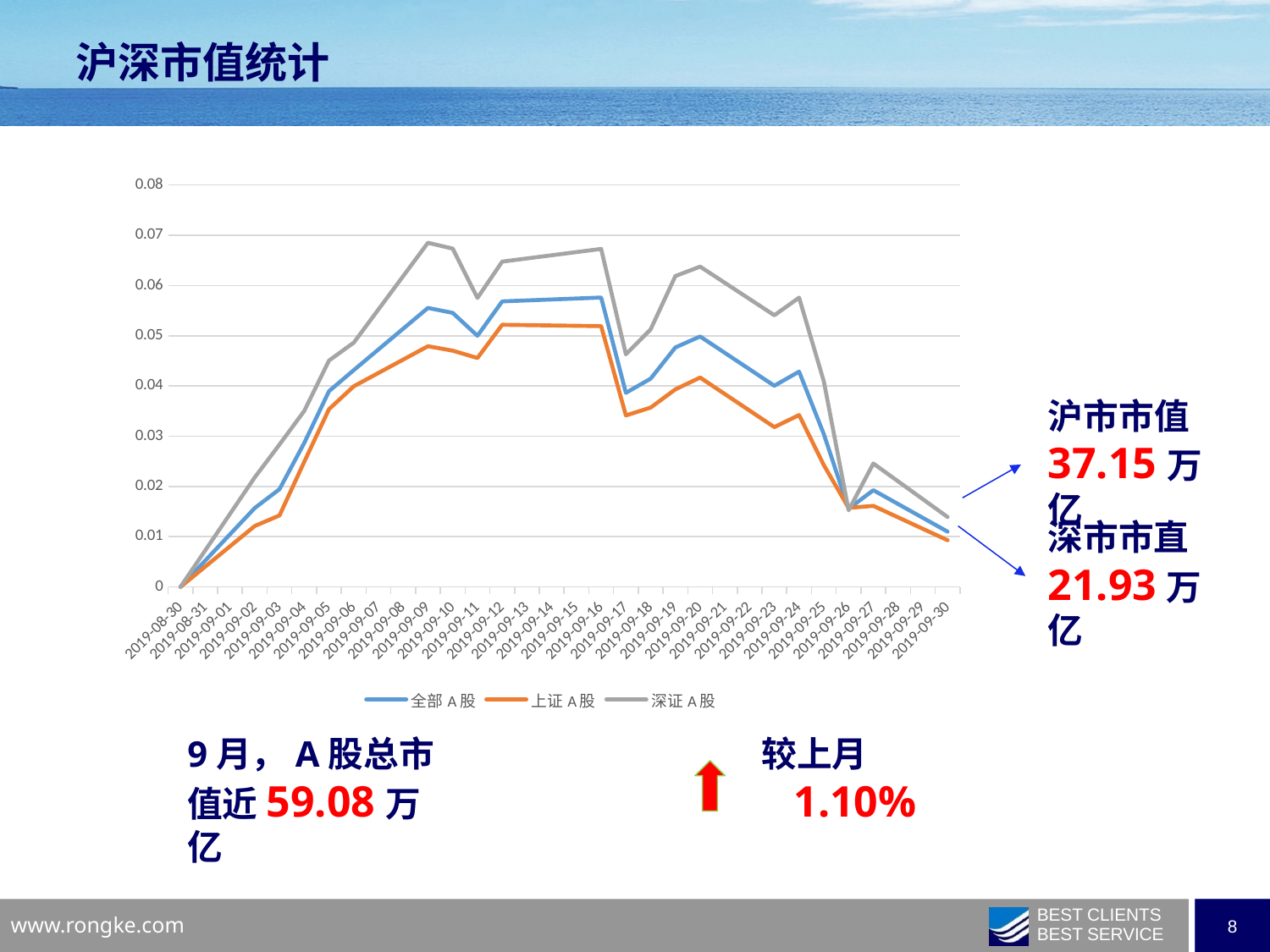
Which colour is used for the 深证A股 series? grey Is the value for 深证A股 on 2019-09-09 greater or less than 0.06? greater On 2019-09-17, which is larger: 深证A股 or 上证A股? 深证A股 Which series has the lowest values across the chart? 上证A股 Which series has the highest value on 2019-09-09? 深证A股 What is the title of the chart on the slide? 沪深市值统计 How many series does the legend list? 3 Is the value for 全部A股 on 2019-09-30 greater or less than 0.02? less What kind of chart is shown on the slide? line chart Is the value for 上证A股 on 2019-09-26 greater or less than 0.02? less Do the values for 全部A股 rise or fall from 2019-08-30 to 2019-09-09? rise How many dates are shown along the x axis? 32